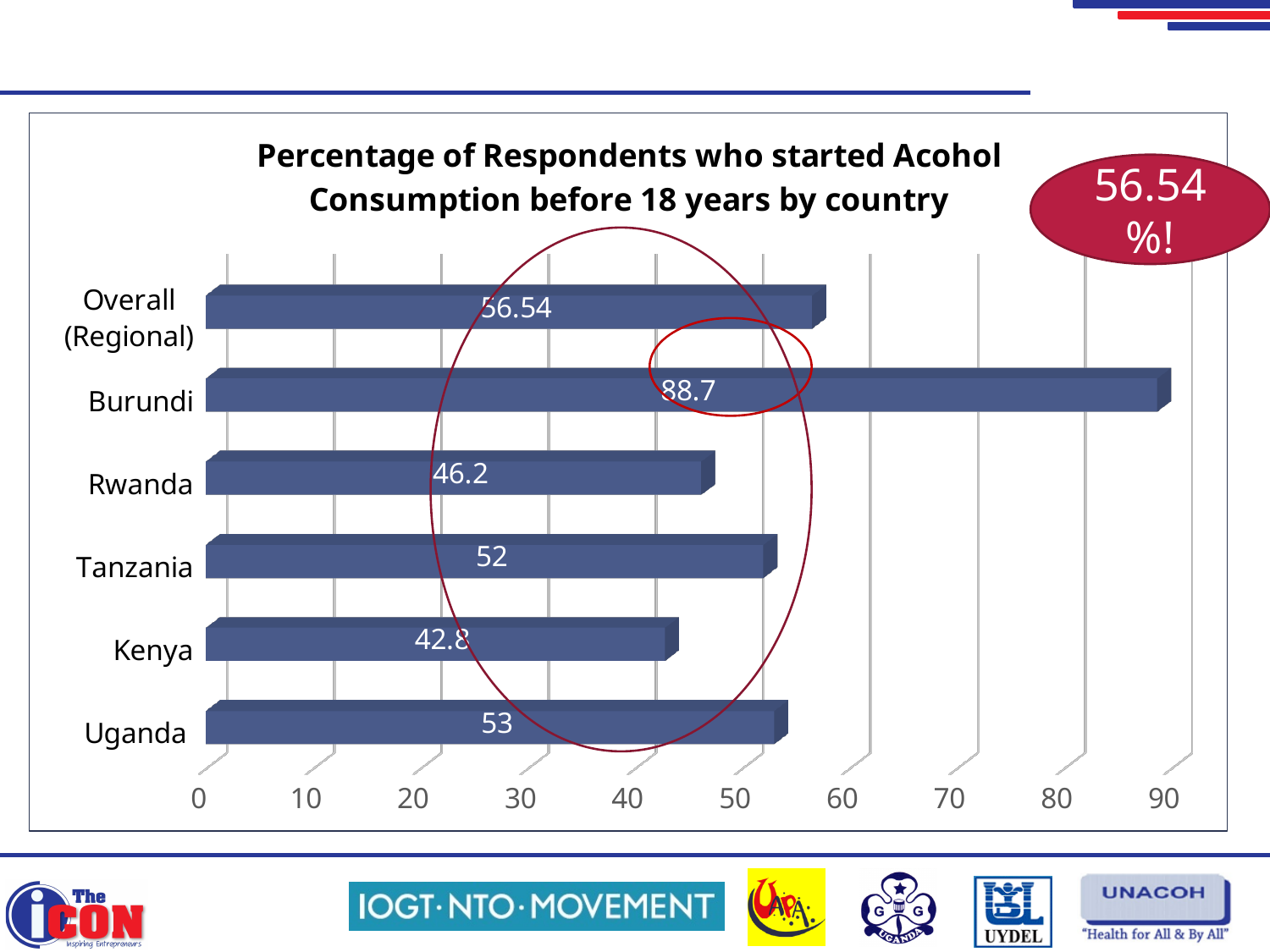
What is the value for Overall (Regional)? 56.54 Is the value for Rwanda greater or less than 50? less What is the difference between the values for Burundi and Kenya? 45.9 What is the title of the chart? Percentage of Respondents who started Acohol Consumption before 18 years by country What is the value for Kenya? 42.8 How many categories are plotted in the chart? 6 Which category has the lowest value in the chart? Kenya Which has a larger value, Tanzania or Uganda? Uganda Which country has the highest percentage of respondents who started alcohol consumption before 18 years? Burundi What kind of chart is shown on the slide? bar chart What is the value for Rwanda? 46.2 What is the value for Burundi? 88.7